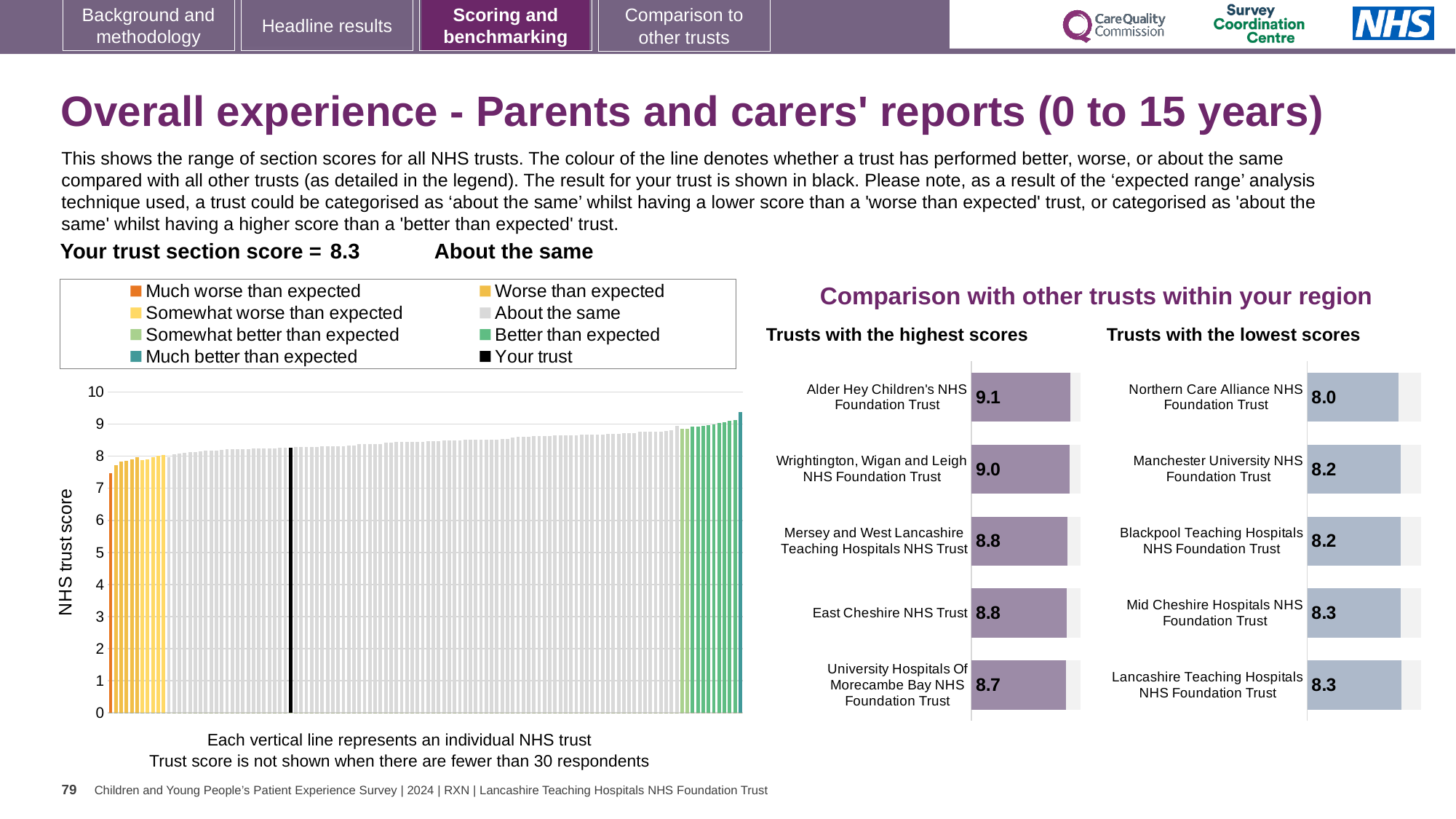
In the 'Trusts with the highest scores' chart, what is the difference between the scores of Alder Hey Children's NHS Foundation Trust and University Hospitals Of Morecambe Bay NHS Foundation Trust? 0.4 How many trusts are shown in the 'Trusts with the highest scores' chart? 5 In the 'Trusts with the lowest scores' chart, which trust has the lowest score? Northern Care Alliance NHS Foundation Trust In the 'Trusts with the highest scores' chart, which trust has the highest score? Alder Hey Children's NHS Foundation Trust In the 'Trusts with the lowest scores' chart, what is the score for Northern Care Alliance NHS Foundation Trust? 8.0 In the 'Trusts with the highest scores' chart, what is the score for University Hospitals Of Morecambe Bay NHS Foundation Trust? 8.7 How many entries does the legend of the large chart on the left list? 8 In the 'Trusts with the lowest scores' chart, what is the score for Lancashire Teaching Hospitals NHS Foundation Trust? 8.3 In the large chart on the left, do the trust scores rise or fall from left to right along the x axis? Rise What kind of chart is the large chart on the left showing NHS trust scores? Bar chart In the 'Trusts with the lowest scores' chart, which has the higher score: Northern Care Alliance NHS Foundation Trust or Mid Cheshire Hospitals NHS Foundation Trust? Mid Cheshire Hospitals NHS Foundation Trust In the 'Trusts with the highest scores' chart, what is the score for Alder Hey Children's NHS Foundation Trust? 9.1